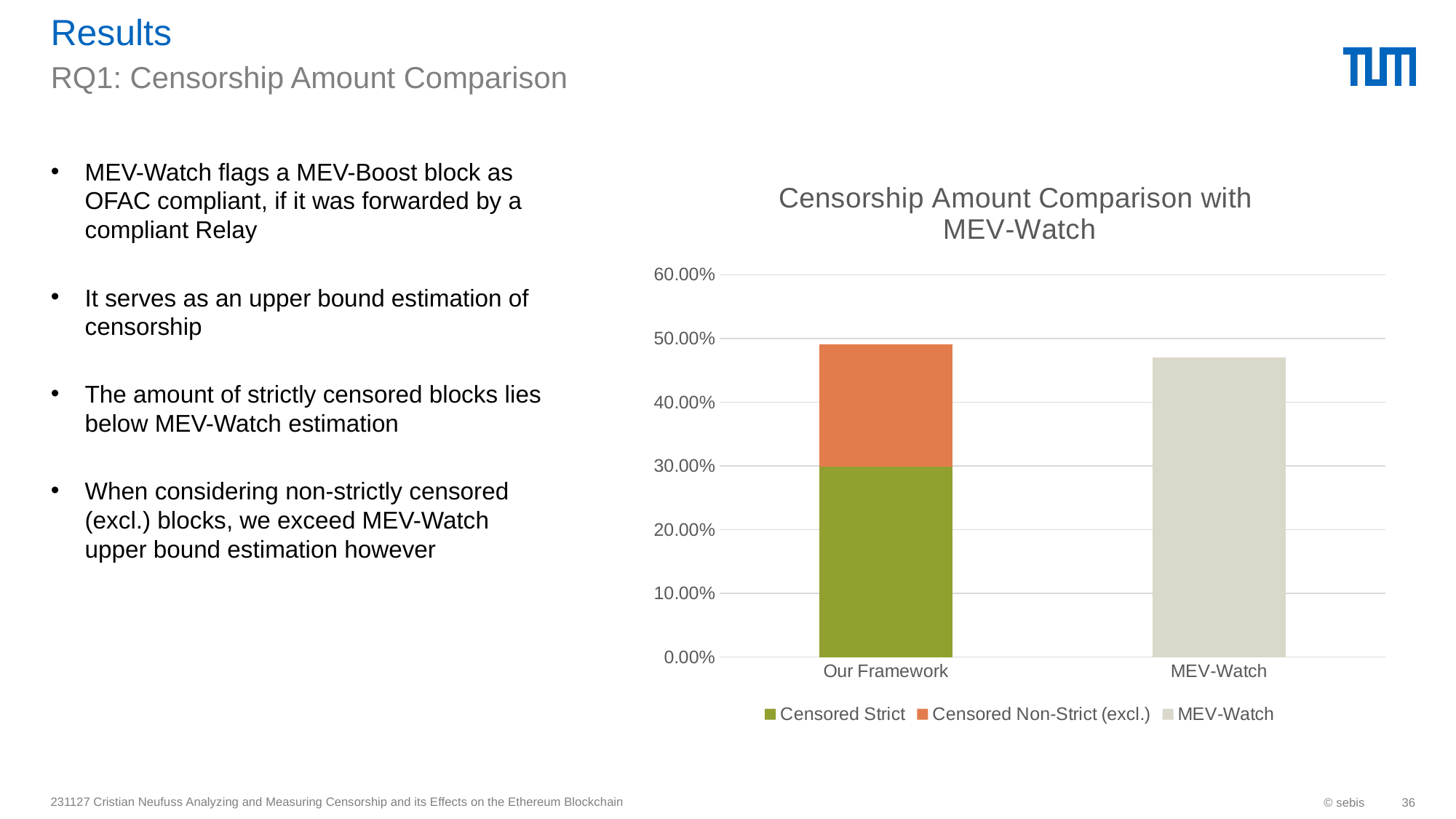
What kind of chart is shown on the slide? stacked bar chart Which bar reaches higher in total: Our Framework or MEV-Watch? Our Framework Which series is shown in green in the chart? Censored Strict Is the value for Censored Strict in the Our Framework bar greater or less than 40.00%? less How many categories are shown on the x axis of the chart? 2 Is the total height of the Our Framework stacked bar greater or less than 40.00%? greater How many series does the chart legend list? 3 Is the value for the MEV-Watch bar greater or less than 50.00%? less What is the title of the chart? Censorship Amount Comparison with MEV-Watch